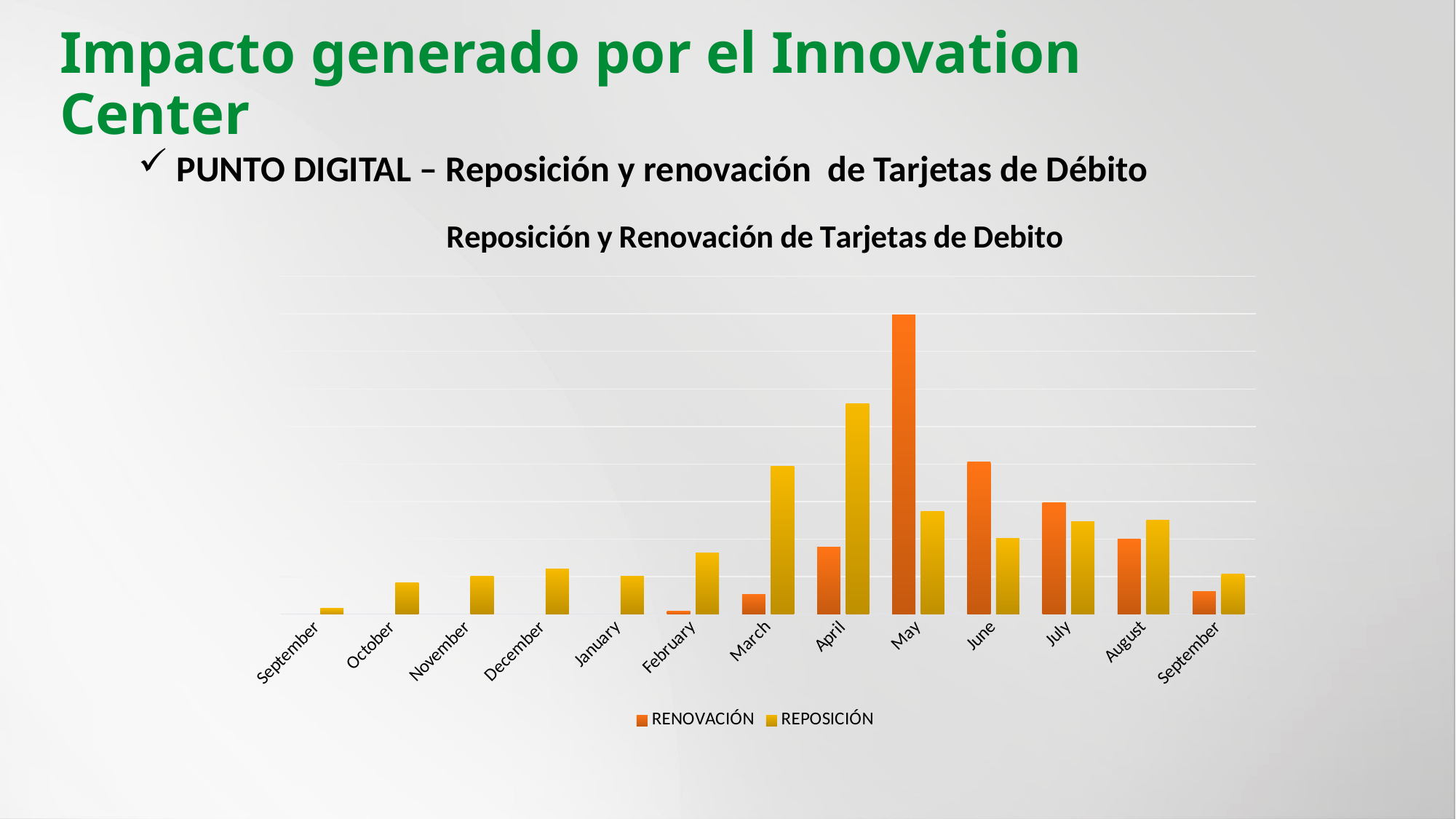
In which month is the RENOVACIÓN value highest? May How many categories are shown along the x axis of the chart? 13 Does the REPOSICIÓN value rise or fall from February to April? rise How many series does the chart legend list? 2 What kind of chart is shown on the slide? bar chart Which month has the larger REPOSICIÓN value, March or April? April In which month is the REPOSICIÓN value highest? April What is the title of the chart? Reposición y Renovación de Tarjetas de Debito In April, which series has the larger value, RENOVACIÓN or REPOSICIÓN? REPOSICIÓN In May, which series has the larger value, RENOVACIÓN or REPOSICIÓN? RENOVACIÓN Which series is shown in orange in the chart? RENOVACIÓN Does the RENOVACIÓN value rise or fall from May to August? fall